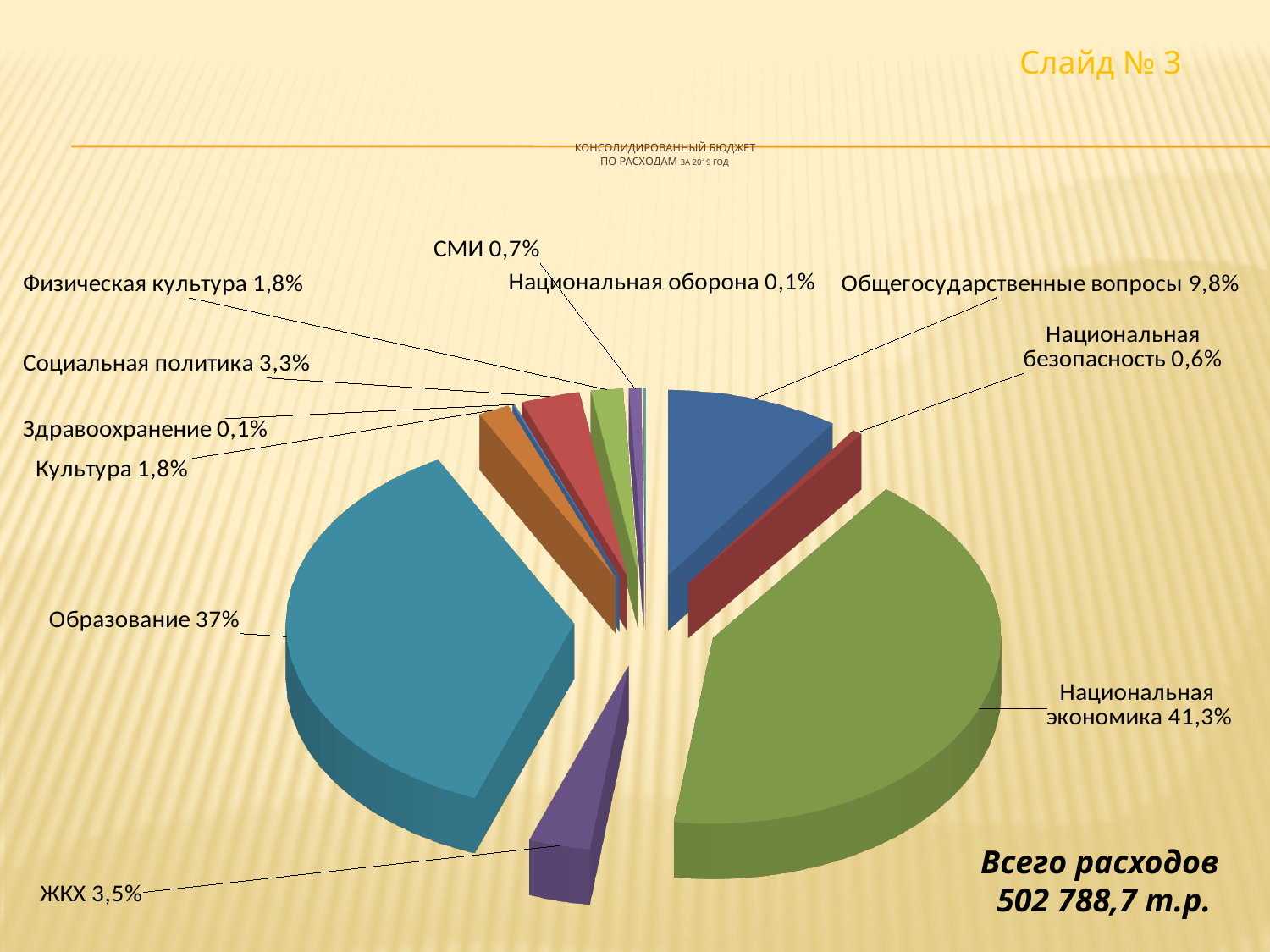
Какой тип диаграммы показан на слайде? Круговая диаграмма На сколько процентных пунктов доля национальной экономики больше доли образования? 4,3 Какова доля расходов на СМИ? 0,7% Какая категория расходов имеет наибольшую долю? Национальная экономика Сколько категорий расходов показано на диаграмме? 11 Какая доля расходов приходится на ЖКХ? 3,5% Какая доля больше: социальная политика или ЖКХ? ЖКХ Какая доля расходов приходится на общегосударственные вопросы? 9,8% Какая доля расходов приходится на образование? 37% Какова общая сумма расходов, указанная на слайде? 502 788,7 т.р. За какой год представлен консолидированный бюджет по расходам? 2019 Какая доля расходов приходится на национальную экономику? 41,3%